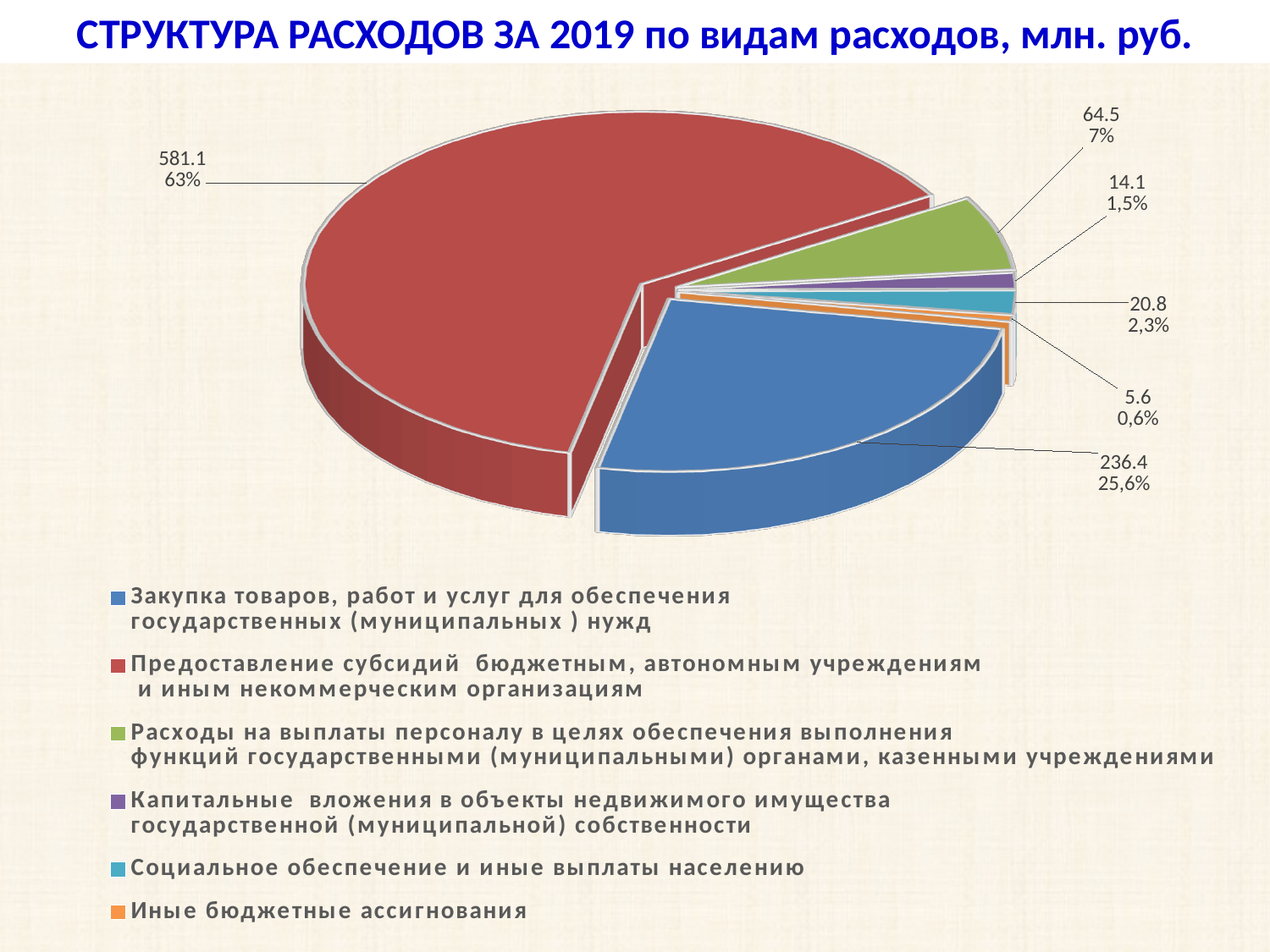
Which category has the smallest slice of the pie? Иные бюджетные ассигнования Which category has the largest slice of the pie? Предоставление субсидий бюджетным, автономным учреждениям и иным некоммерческим организациям What is the value (млн. руб.) for «Закупка товаров, работ и услуг для обеспечения государственных (муниципальных) нужд»? 236.4 What is the difference in млн. руб. between «Предоставление субсидий…» (581.1) and «Закупка товаров, работ и услуг…» (236.4)? 344.7 What share of the pie does «Иные бюджетные ассигнования» have? 0,6% Which is larger: «Социальное обеспечение и иные выплаты населению» or «Капитальные вложения в объекты недвижимого имущества…»? Социальное обеспечение и иные выплаты населению What is the value (млн. руб.) for «Социальное обеспечение и иные выплаты населению»? 20.8 What is the value (млн. руб.) for «Расходы на выплаты персоналу в целях обеспечения выполнения функций государственными (муниципальными) органами, казенными учреждениями»? 64.5 What share of the pie does «Капитальные вложения в объекты недвижимого имущества государственной (муниципальной) собственности» have? 1,5% What type of chart is shown on the slide? pie chart How many categories does the legend of the pie chart list? 6 What is the value (млн. руб.) for «Предоставление субсидий бюджетным, автономным учреждениям и иным некоммерческим организациям»? 581.1